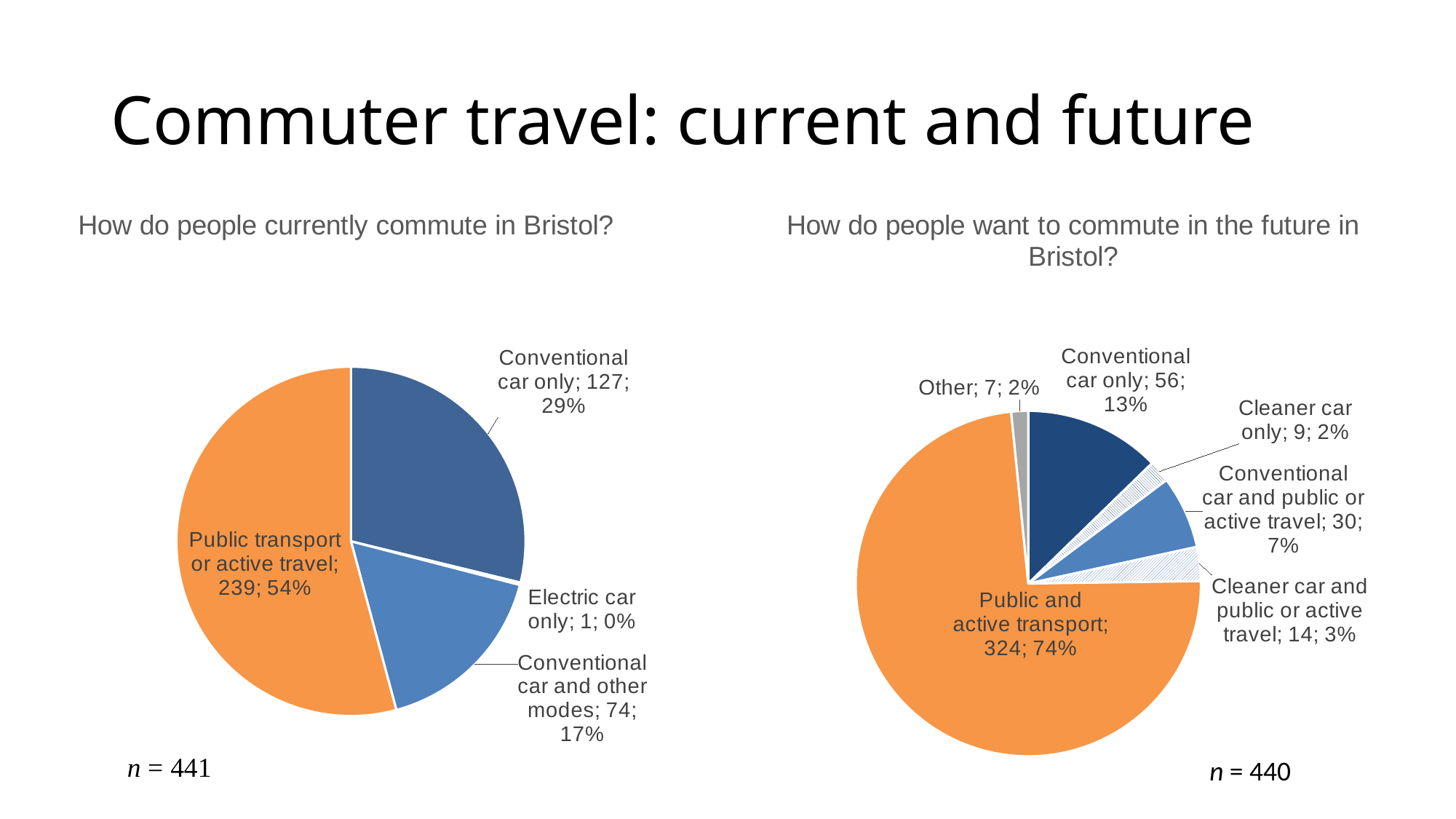
In the chart 'How do people want to commute in the future in Bristol?', what share of the pie is 'Conventional car only'? 13% In the chart 'How do people currently commute in Bristol?', how many slices does the pie have? 4 In the chart 'How do people currently commute in Bristol?', what share of the pie is 'Public transport or active travel'? 54% In the chart 'How do people currently commute in Bristol?', which category has the smallest slice? Electric car only In the chart 'How do people currently commute in Bristol?', how many people commute by conventional car only? 127 What is the sample size (n) shown for the chart 'How do people want to commute in the future in Bristol?'? 440 In the chart 'How do people want to commute in the future in Bristol?', which category has the largest slice? Public and active transport In the chart 'How do people currently commute in Bristol?', what is the difference between the counts for 'Conventional car only' and 'Conventional car and other modes'? 53 In the chart 'How do people want to commute in the future in Bristol?', how many slices does the pie have? 6 What type of chart is used on the left side of the slide? Pie chart In the chart 'How do people want to commute in the future in Bristol?', which is larger: 'Conventional car and public or active travel' or 'Cleaner car and public or active travel'? Conventional car and public or active travel In the chart 'How do people want to commute in the future in Bristol?', how many people chose 'Public and active transport'? 324